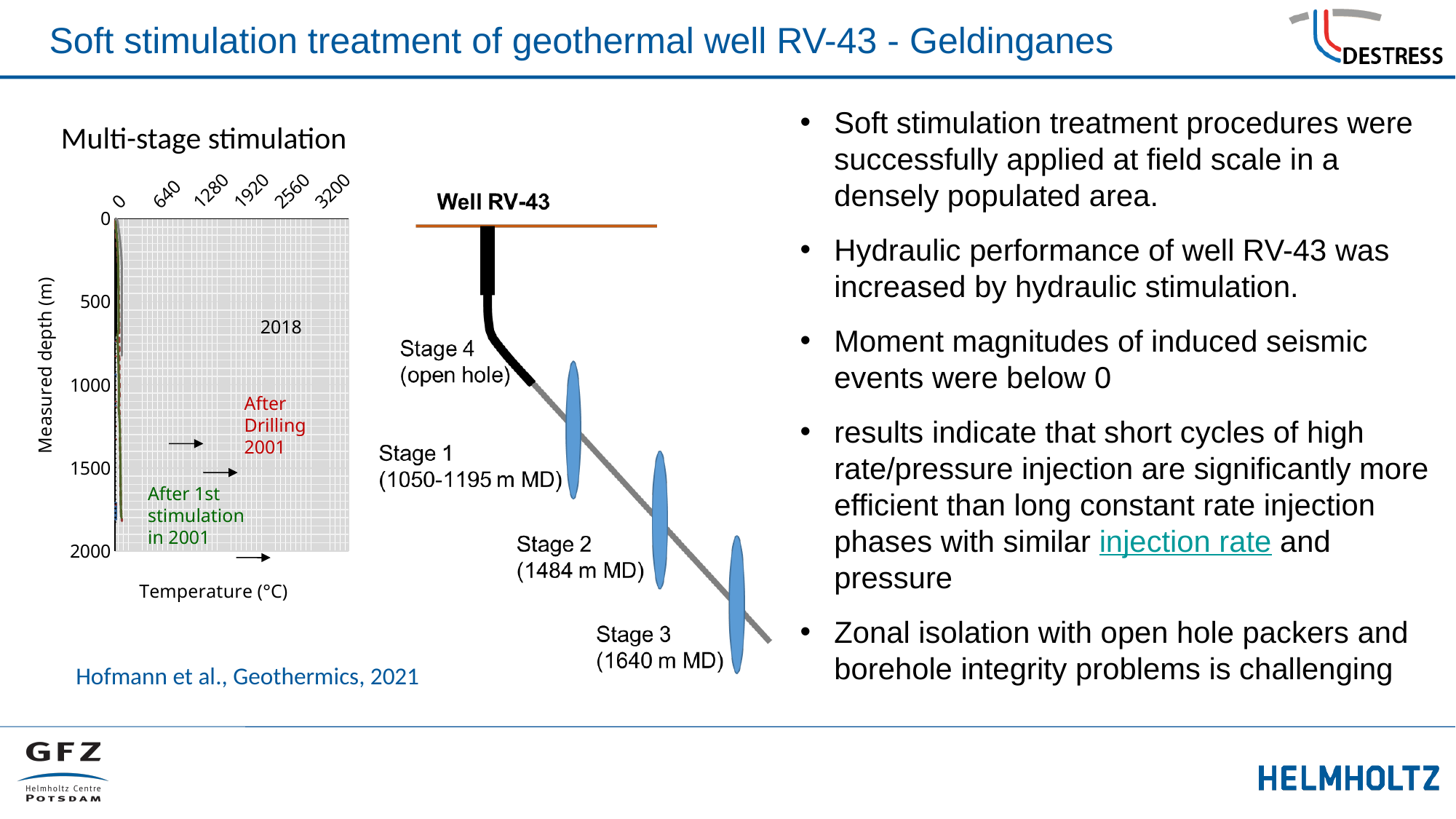
On the 'Multi-stage stimulation' chart, is the temperature of the 2018 curve at 1000 m measured depth greater or less than 640? less On the 'Multi-stage stimulation' chart, is the temperature of the 'After Drilling 2001' curve at 500 m measured depth greater or less than 640? less How many tick labels are shown on the temperature axis of the 'Multi-stage stimulation' chart? 6 What is the largest tick value shown on the measured depth axis of the 'Multi-stage stimulation' chart? 2000 On the 'Multi-stage stimulation' chart, is the temperature of the 'After 1st stimulation in 2001' curve at 1500 m measured depth greater or less than 1280? less How many data series are labelled on the 'Multi-stage stimulation' chart? 3 What is the largest tick value shown on the temperature axis of the 'Multi-stage stimulation' chart? 3200 What is the label of the horizontal axis on the 'Multi-stage stimulation' chart? Temperature (°C) What is the label of the vertical axis on the 'Multi-stage stimulation' chart? Measured depth (m) What kind of chart is the 'Multi-stage stimulation' plot on the left of the slide? line chart